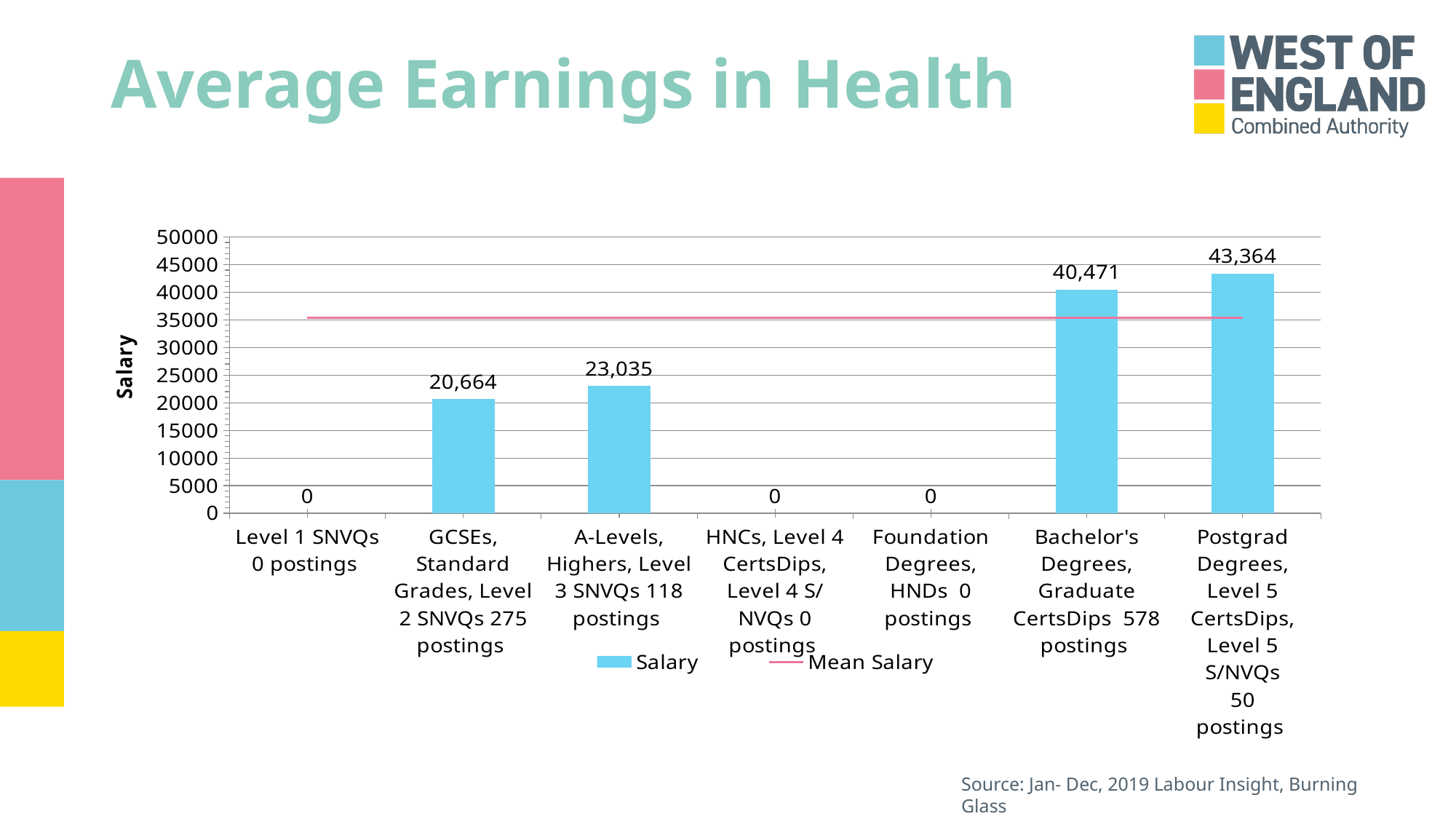
How many categories have a salary value of 0? 3 How many series does the legend list? 2 How many categories are shown on the x axis? 7 What is the salary value for Bachelor's Degrees, Graduate CertsDips? 40,471 Which is larger, the salary for A-Levels, Highers, Level 3 SNVQs or for GCSEs, Standard Grades, Level 2 SNVQs? A-Levels, Highers, Level 3 SNVQs What kind of chart is shown on the slide? Combination bar and line chart What is the salary value for GCSEs, Standard Grades, Level 2 SNVQs? 20,664 What is the difference in salary between Postgrad Degrees and Bachelor's Degrees? 2,893 What is the difference in salary between A-Levels, Highers, Level 3 SNVQs and GCSEs, Standard Grades, Level 2 SNVQs? 2,371 Is the Mean Salary line greater or less than 30000? greater What is the salary value for Postgrad Degrees, Level 5 CertsDips, Level 5 S/NVQs? 43,364 Which category has the highest salary? Postgrad Degrees, Level 5 CertsDips, Level 5 S/NVQs